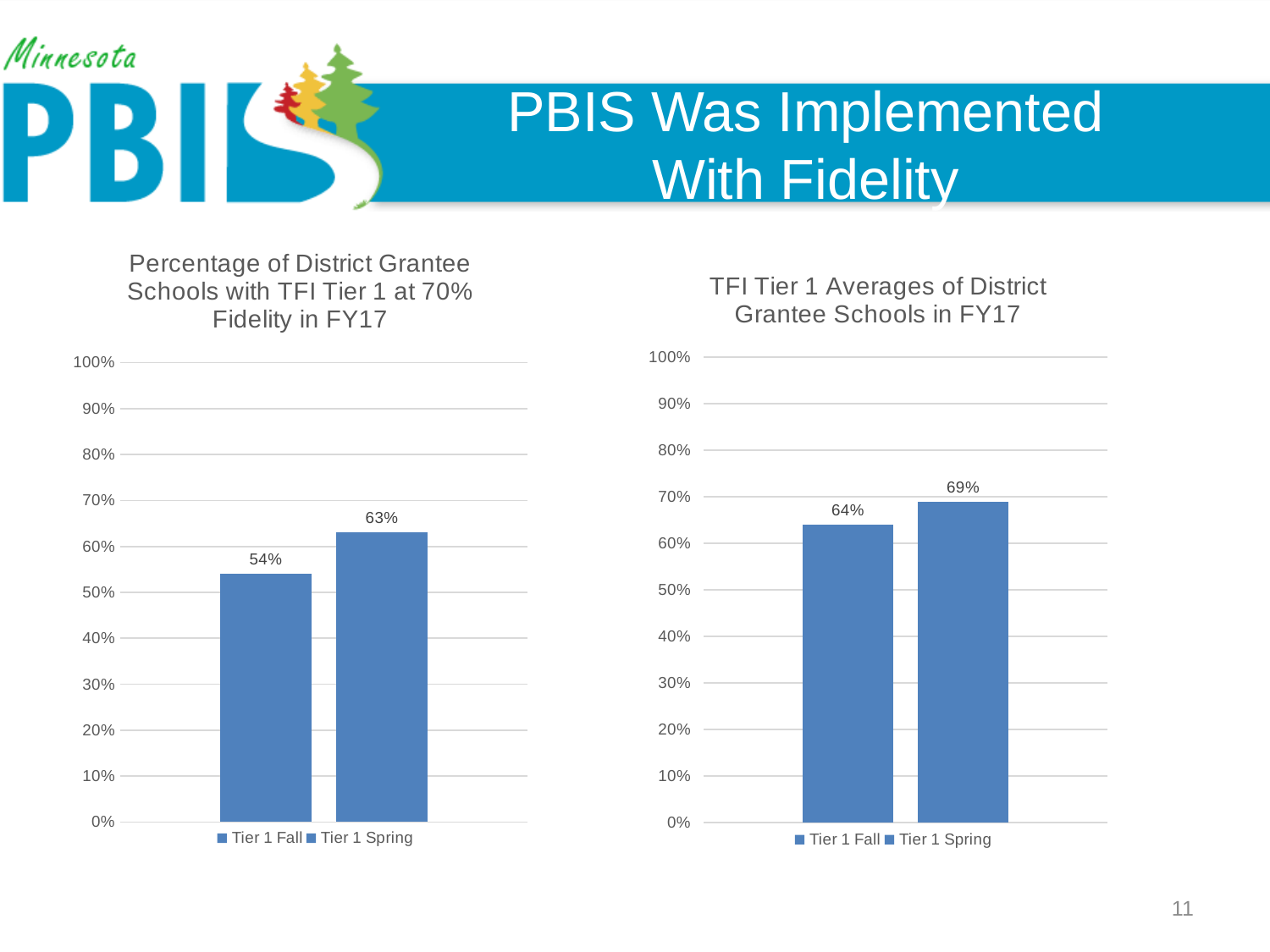
What is the title of the left chart? Percentage of District Grantee Schools with TFI Tier 1 at 70% Fidelity in FY17 In the left chart (Percentage of District Grantee Schools with TFI Tier 1 at 70% Fidelity in FY17), what is the value for Tier 1 Spring? 63% In the right chart, is the value for Tier 1 Fall greater or less than 70%? less In the right chart (TFI Tier 1 Averages of District Grantee Schools in FY17), what is the value for Tier 1 Spring? 69% In the right chart, what is the difference between the Tier 1 Spring and Tier 1 Fall values? 5% In the left chart, what is the difference between the Tier 1 Spring and Tier 1 Fall values? 9% What kind of chart is the right chart (TFI Tier 1 Averages of District Grantee Schools in FY17)? bar chart How many series does the legend of the left chart list? 2 In the left chart (Percentage of District Grantee Schools with TFI Tier 1 at 70% Fidelity in FY17), what is the value for Tier 1 Fall? 54% In the right chart (TFI Tier 1 Averages of District Grantee Schools in FY17), what is the value for Tier 1 Fall? 64% In the left chart, which series has the higher value, Tier 1 Fall or Tier 1 Spring? Tier 1 Spring In the right chart, which series has the lower value? Tier 1 Fall